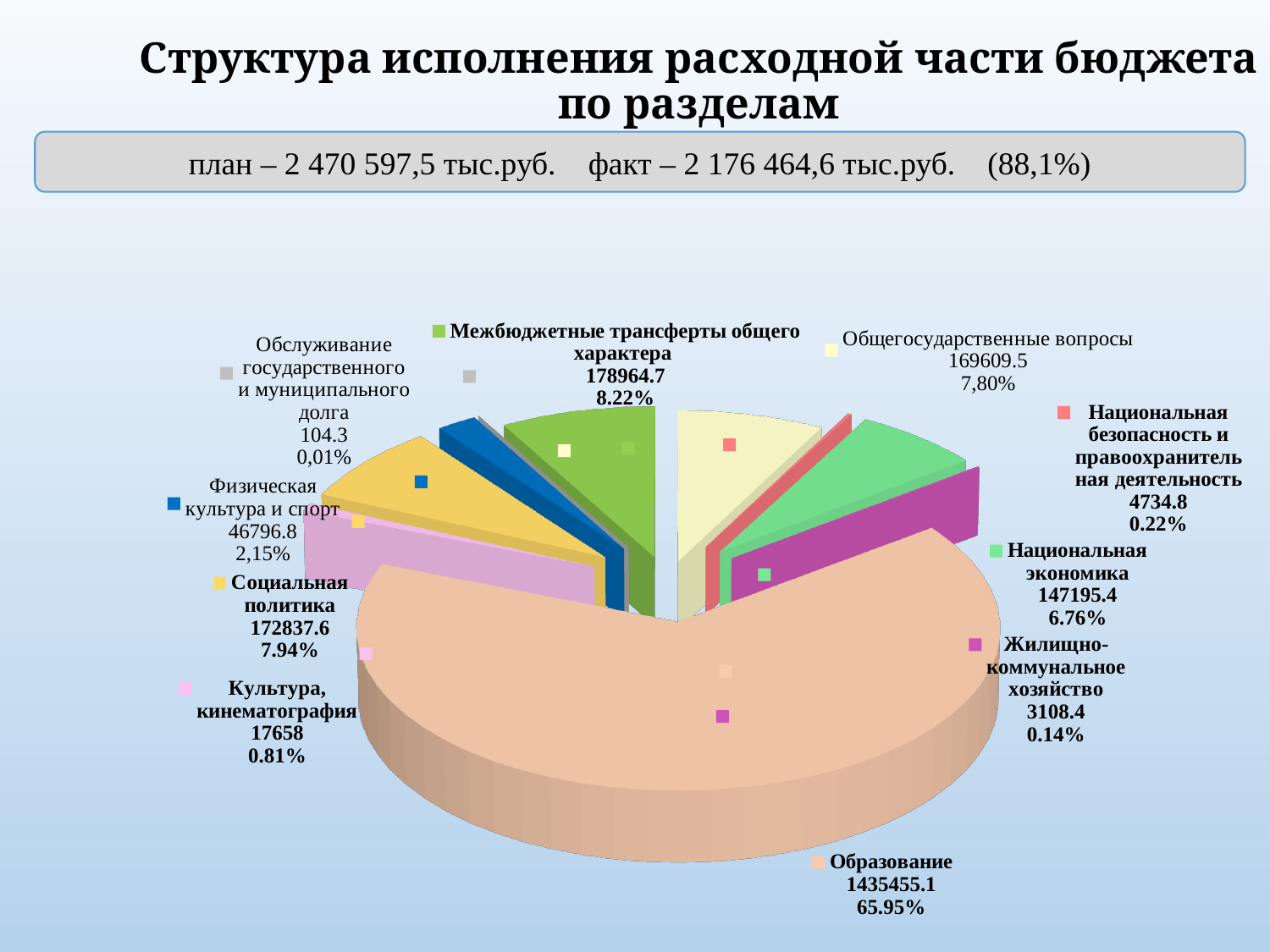
What is the value for Межбюджетные трансферты общего характера? 178964.7 What is the value for Образование? 1435455.1 Which is larger, the value for Социальная политика or for Национальная экономика? Социальная политика Which category has the largest slice of the pie? Образование What share of the pie does Образование take? 65.95% Which category has the smallest value? Обслуживание государственного и муниципального долга What is the value for Физическая культура и спорт? 46796.8 How many categories are shown in the pie chart? 10 What kind of chart is shown on the slide? pie chart What is the difference between the values for Межбюджетные трансферты общего характера and Общегосударственные вопросы? 9355.2 What share of the pie does Национальная экономика take? 6.76% What share of the pie does Жилищно-коммунальное хозяйство take? 0.14%